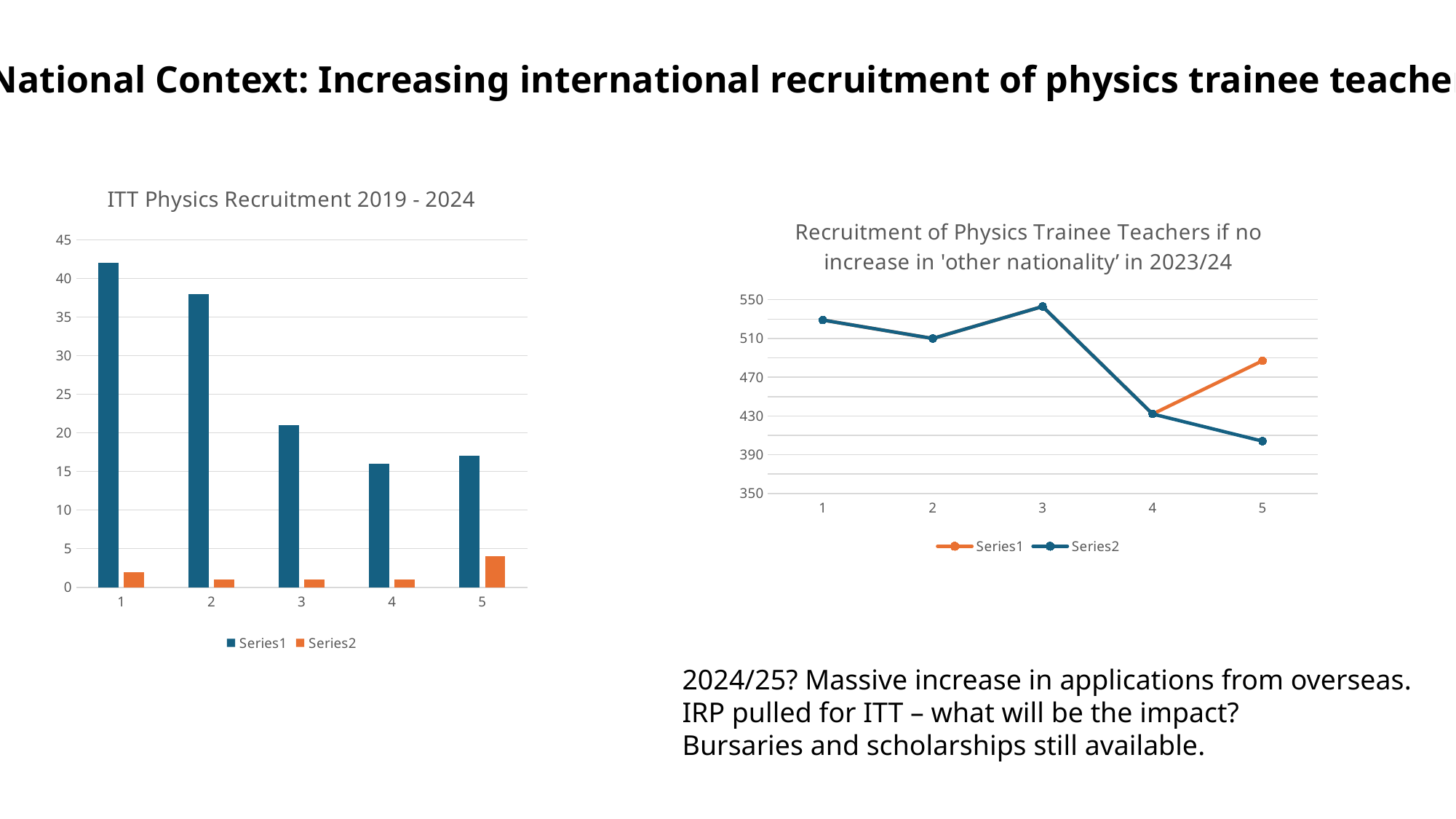
In the 'ITT Physics Recruitment 2019 - 2024' chart, which category has the highest Series1 value? 1 What kind of chart is the 'ITT Physics Recruitment 2019 - 2024' chart on the left? bar chart In the 'ITT Physics Recruitment 2019 - 2024' chart, which is larger: the Series1 value for category 2 or for category 3? category 2 In the 'ITT Physics Recruitment 2019 - 2024' chart, which category has the highest Series2 value? 5 In the 'Recruitment of Physics Trainee Teachers' line chart, which point has the highest Series2 value? 3 In the 'Recruitment of Physics Trainee Teachers' line chart, is the Series1 value at point 5 greater or less than 470? greater What kind of chart is the 'Recruitment of Physics Trainee Teachers if no increase in 'other nationality' in 2023/24' chart on the right? line chart In the 'ITT Physics Recruitment 2019 - 2024' chart, is the Series1 value for category 4 greater or less than 20? less In the 'ITT Physics Recruitment 2019 - 2024' chart, how many series does the legend list? 2 In the 'Recruitment of Physics Trainee Teachers' line chart, is the Series2 value at point 5 greater or less than 430? less In the 'ITT Physics Recruitment 2019 - 2024' chart, how many categories are shown on the x axis? 5